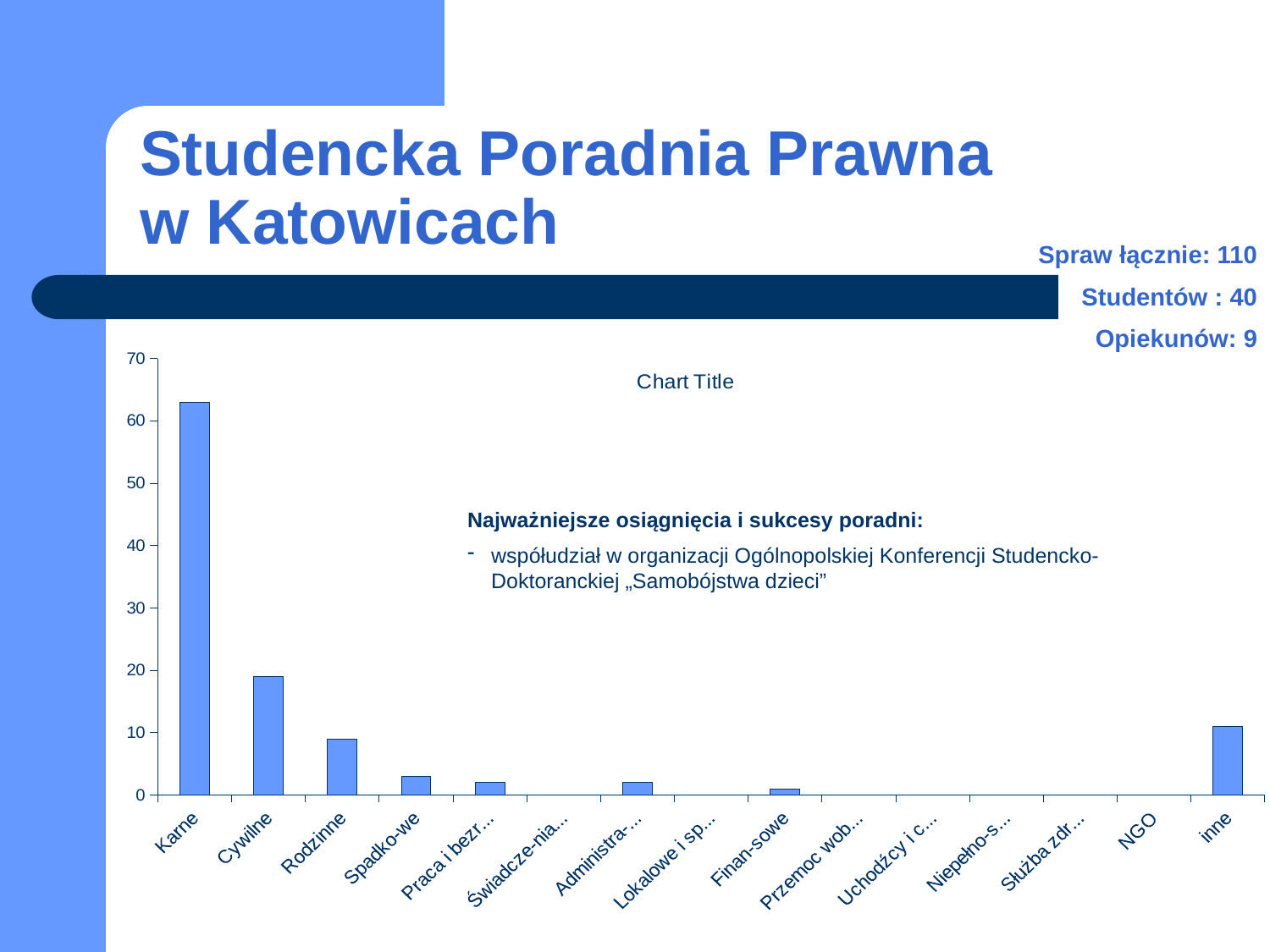
Which category has the highest value in the chart? Karne Is the value for Rodzinne greater or less than 20? less Is the value for Spadko-we greater or less than 10? less Which is larger, the value for Karne or the value for Cywilne? Karne Is the value for Karne greater or less than 60? greater Which is larger, the value for Cywilne or the value for inne? Cywilne How many categories are shown on the x axis of the chart? 15 Which is larger, the value for Rodzinne or the value for Spadko-we? Rodzinne What kind of chart is shown on the slide? bar chart What title is displayed on the chart? Chart Title